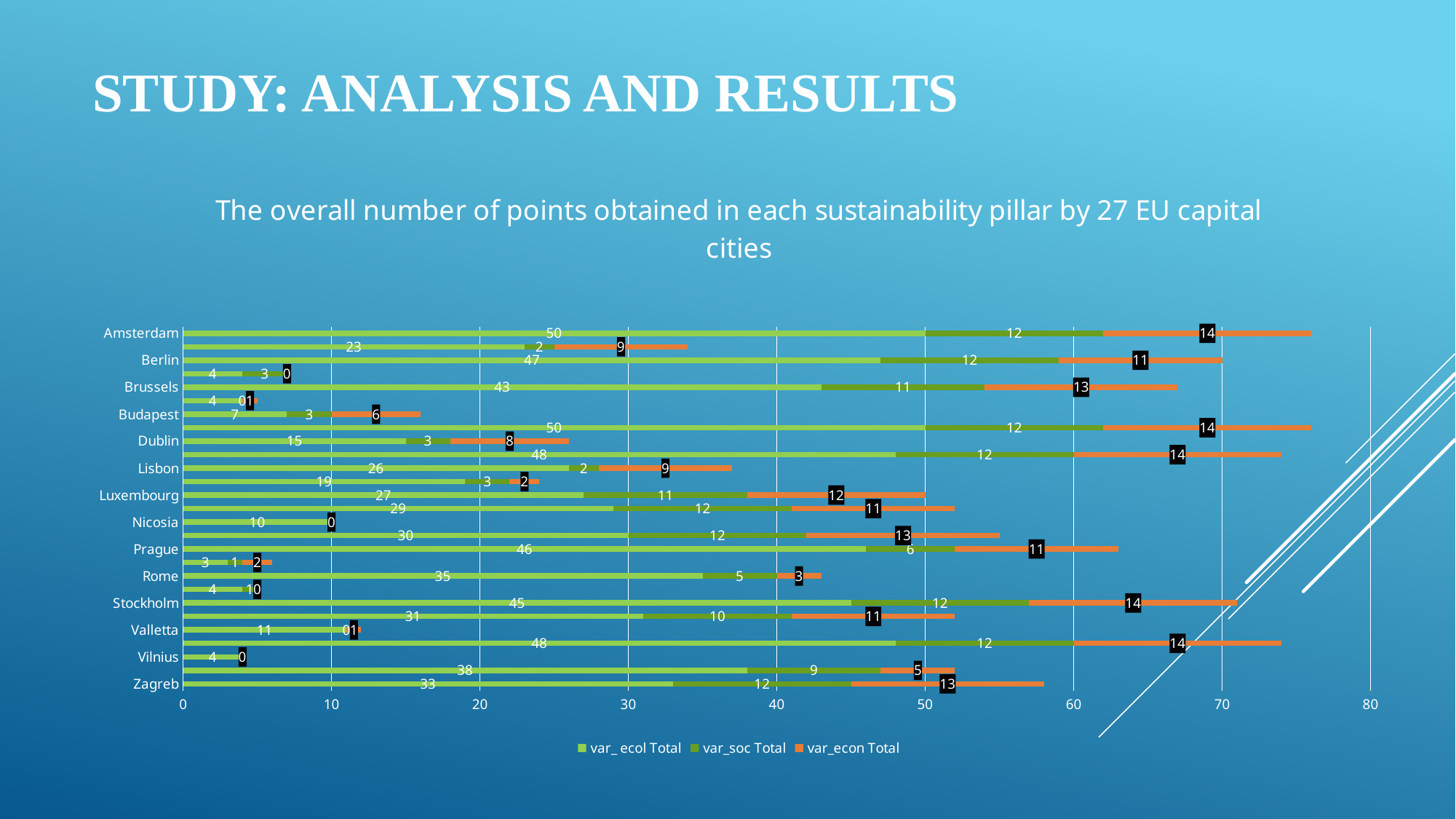
What is the var_soc Total value for Prague? 6 What kind of chart is shown on the slide? Stacked bar chart What is the total of the stacked bar for Budapest? 16 What is the difference between the var_ ecol Total values for Rome and Zagreb? 2 What is the var_econ Total value for Brussels? 13 Which has the larger var_ ecol Total value, Lisbon or Stockholm? Stockholm Is the total length of the stacked bar for Rome greater or less than 40? greater Among Budapest, Rome and Zagreb, which has the lowest var_ ecol Total value? Budapest What is the total of the stacked bar for Amsterdam? 76 What is the var_econ Total value for Stockholm? 14 What is the var_ ecol Total value for Berlin? 47 How many series does the legend list? 3